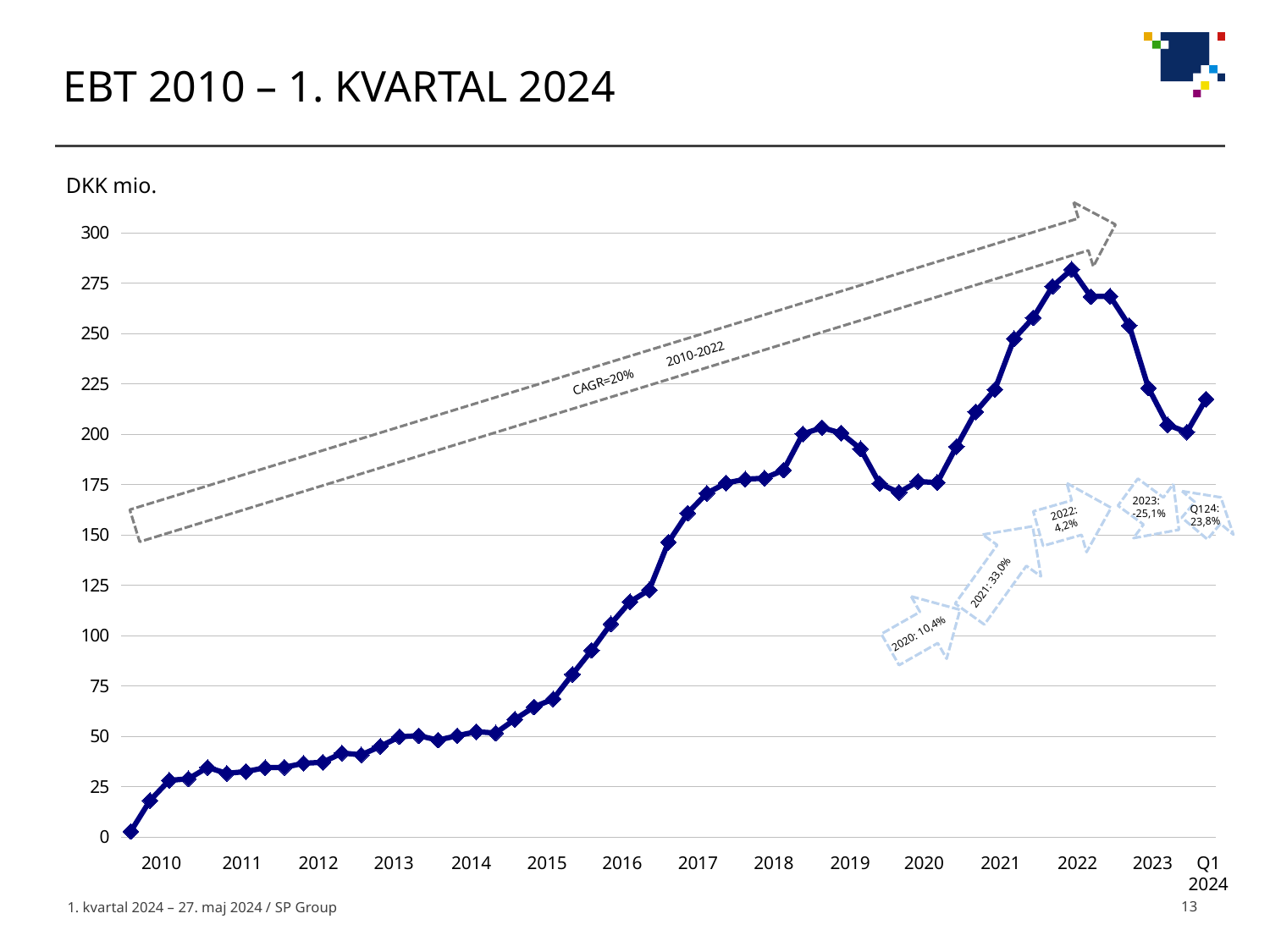
In which year does the line have its lowest point? 2010 What unit is the y axis of the chart measured in? DKK mio. Does the line generally rise or fall from 2010 to 2022? rise Is the value at Q1 2024 greater or less than 200? greater Is the value at 2012 greater or less than 50? less In which year does the line reach its highest point? 2022 What kind of chart is shown on the slide? line chart Is the value at 2018 greater or less than 150? greater What is the title of the chart? EBT 2010 – 1. KVARTAL 2024 Is the value at 2022 larger or smaller than the value at 2023? larger